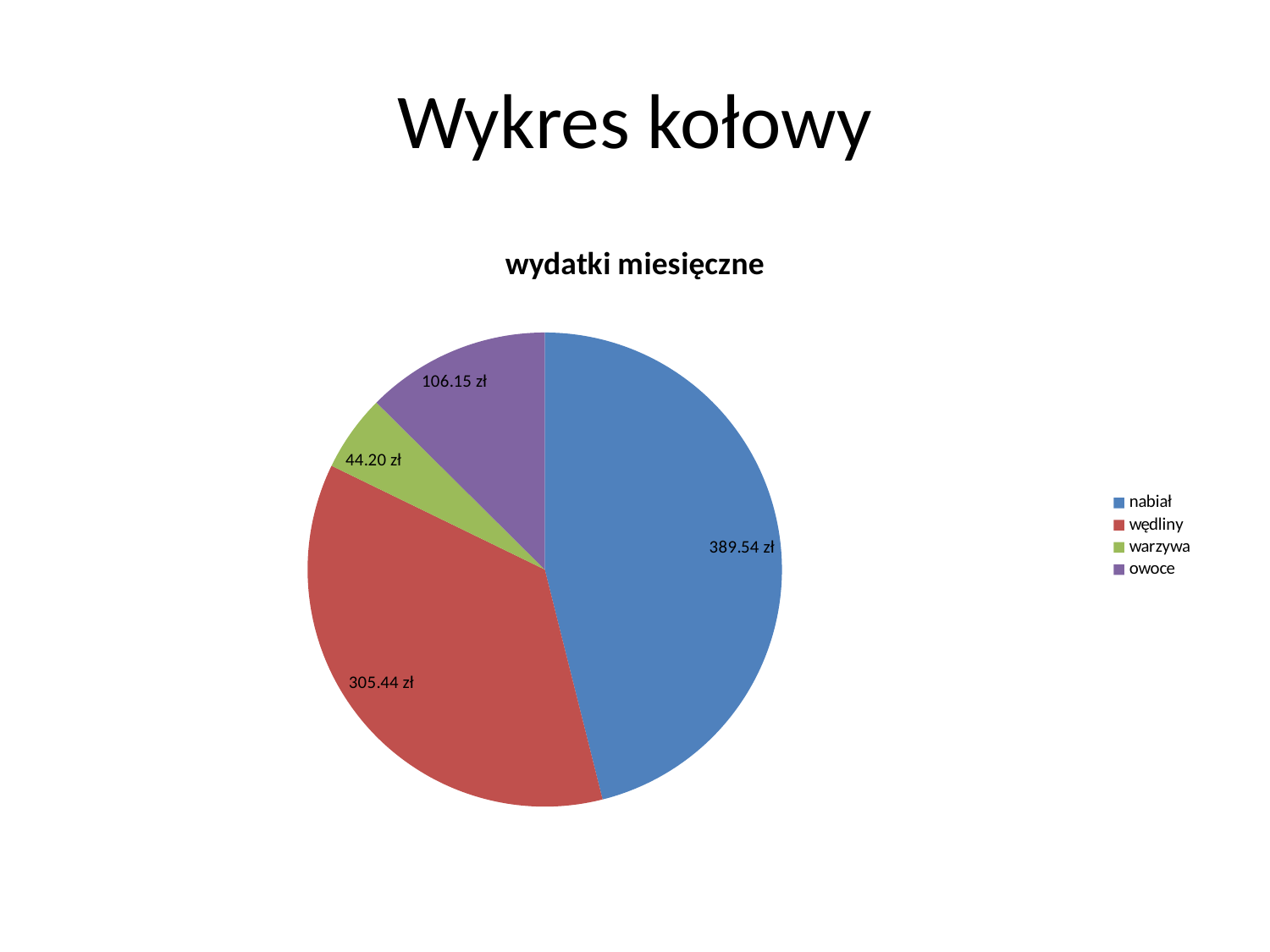
How many categories does the pie chart show? 4 What is the total of all four slices? 845.33 zł What is the value for nabiał? 389.54 zł What is the value for warzywa? 44.20 zł What type of chart is shown on the slide? pie chart What is the value for owoce? 106.15 zł What is the title of the chart? wydatki miesięczne Which category has the largest slice? nabiał Which is larger, the value for owoce or the value for warzywa? owoce What is the difference between the value for nabiał and the value for wędliny? 84.10 zł Which category has the smallest slice? warzywa What is the value for wędliny? 305.44 zł